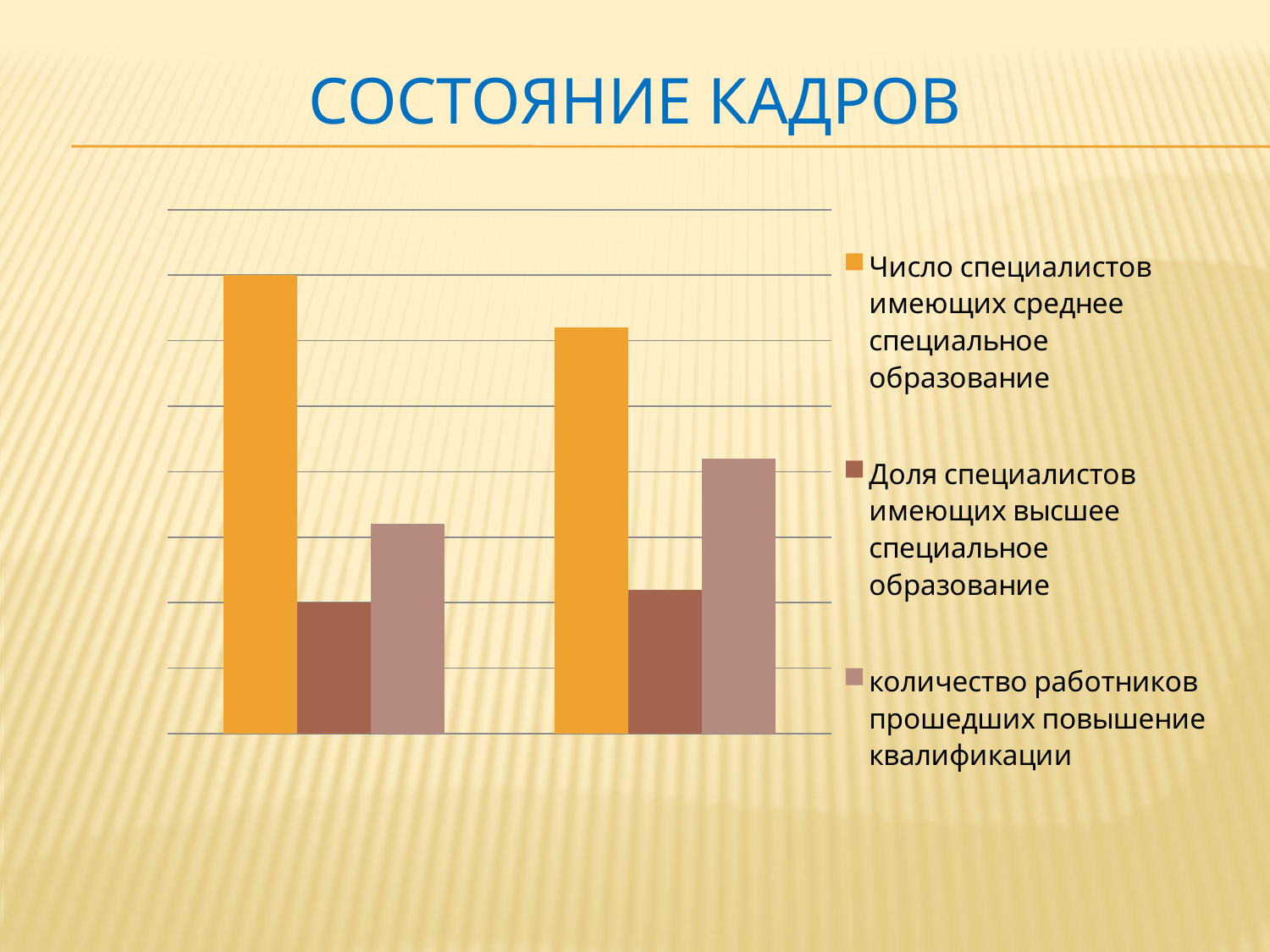
What kind of chart is shown on the slide? bar chart For the series 'Число специалистов имеющих среднее специальное образование', is the bar in the left group or the right group taller? left group In the left group of bars, which series has the lowest bar? Доля специалистов имеющих высшее специальное образование In the right group of bars, which series has the lowest bar? Доля специалистов имеющих высшее специальное образование What is the title of the slide containing the chart? СОСТОЯНИЕ КАДРОВ For the series 'количество работников прошедших повышение квалификации', is the bar in the left group or the right group taller? right group In the left group of bars, which series has the highest bar? Число специалистов имеющих среднее специальное образование Which series is shown in orange in the legend? Число специалистов имеющих среднее специальное образование In the right group of bars, which series has the highest bar? Число специалистов имеющих среднее специальное образование Does the value for 'Число специалистов имеющих среднее специальное образование' rise or fall from the left group to the right group? fall How many series does the legend list? 3 How many groups of bars are plotted in the chart? 2